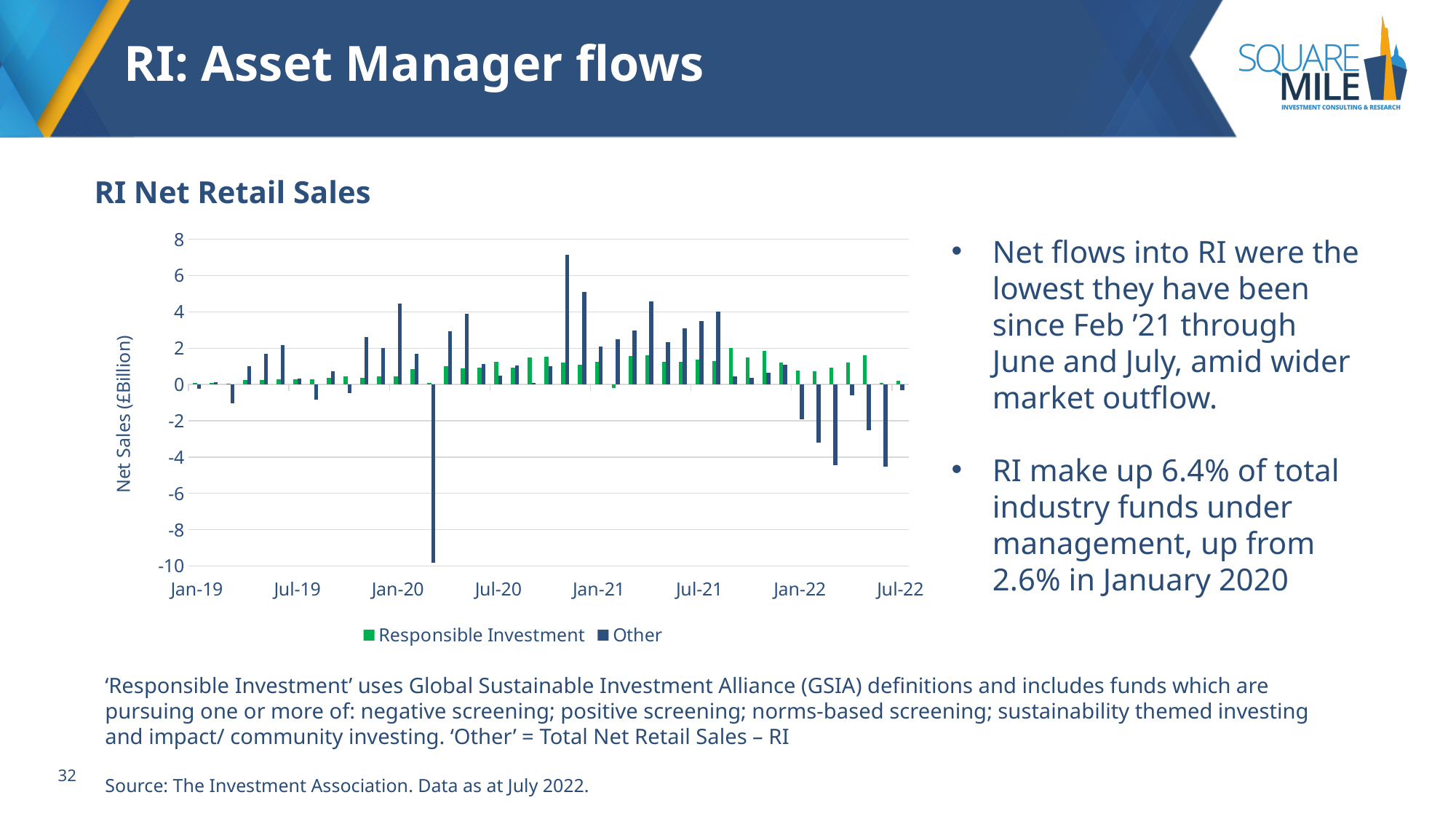
In the RI Net Retail Sales chart, which series reaches the highest value on the chart, Responsible Investment or Other? Other Is the highest value for the Other series in the RI Net Retail Sales chart greater or less than 6? greater In the RI Net Retail Sales chart, are the Other series values in 2022 mostly positive or mostly negative? mostly negative What are the two series named in the legend of the RI Net Retail Sales chart? Responsible Investment and Other Is the value for Other at Jan-20 in the RI Net Retail Sales chart greater or less than 2? greater How many series does the legend of the RI Net Retail Sales chart list? 2 In the RI Net Retail Sales chart, which series reaches the lowest value on the chart, Responsible Investment or Other? Other What type of chart is shown under the title 'RI Net Retail Sales'? Bar chart Is the highest value for the Responsible Investment series in the RI Net Retail Sales chart greater or less than 1? greater What is the label on the vertical axis of the RI Net Retail Sales chart? Net Sales (£Billion)